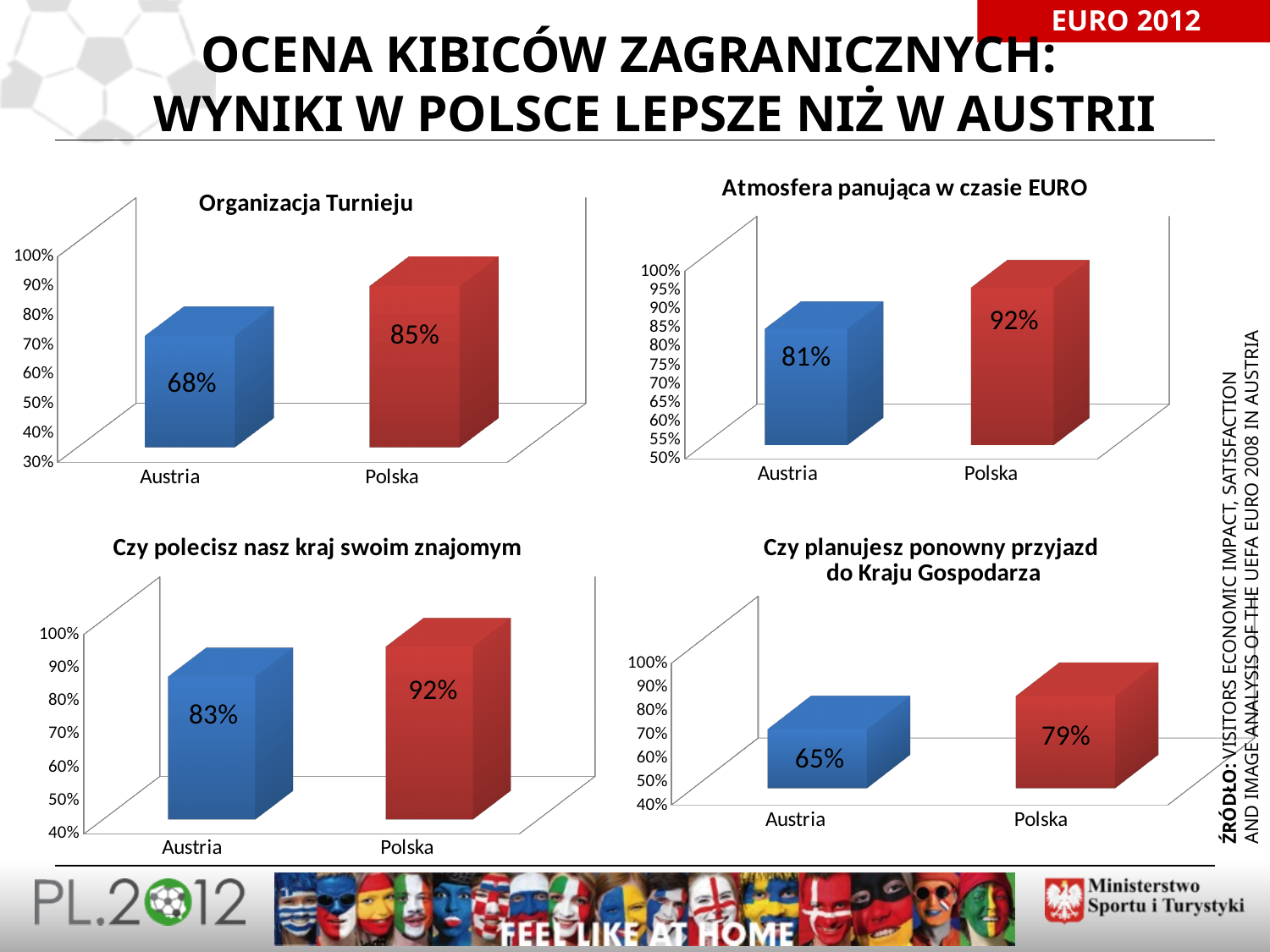
In the 'Organizacja Turnieju' chart, what is the value for Polska? 85% How many charts are shown on the slide? 4 In the 'Czy polecisz nasz kraj swoim znajomym' chart, which category has the lowest value? Austria In the 'Organizacja Turnieju' chart, what is the value for Austria? 68% What type of chart is the 'Atmosfera panująca w czasie EURO' chart? Bar chart How many categories are shown in the 'Organizacja Turnieju' chart? 2 In the 'Czy polecisz nasz kraj swoim znajomym' chart, what is the value for Polska? 92% In the 'Czy planujesz ponowny przyjazd do Kraju Gospodarza' chart, what is the difference between the values for Polska and Austria? 14% In the 'Organizacja Turnieju' chart, what is the difference between the values for Polska and Austria? 17% In the 'Czy planujesz ponowny przyjazd do Kraju Gospodarza' chart, what is the value for Austria? 65% In the 'Atmosfera panująca w czasie EURO' chart, which country has the higher value? Polska In the 'Atmosfera panująca w czasie EURO' chart, what is the value for Austria? 81%